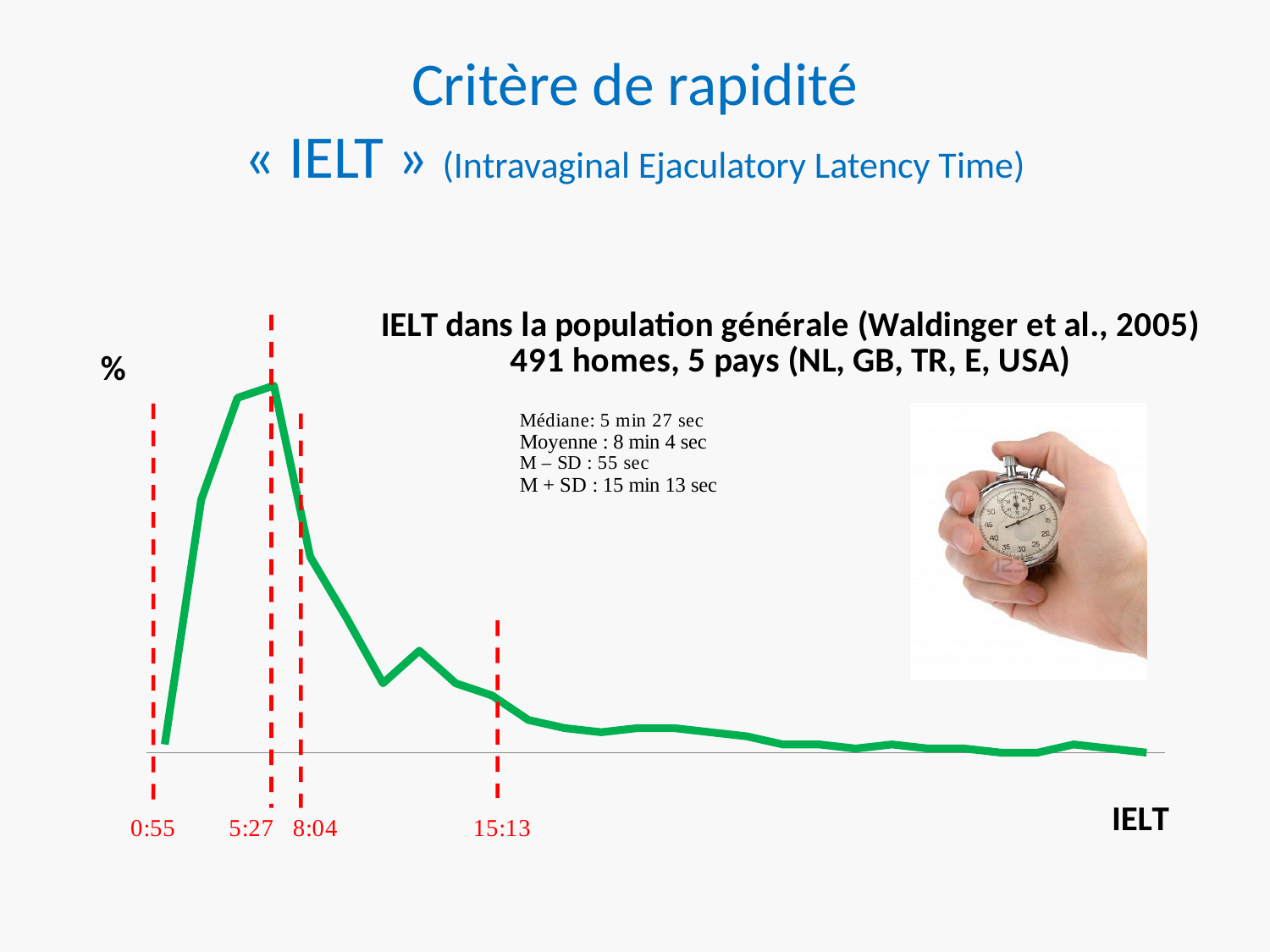
What label is shown on the x axis of the chart? IELT Is the value of the green line at the 8:04 marker higher or lower than at the 15:13 marker? higher Does the green line rise or fall between the 0:55 marker and the 5:27 marker? rise What is the mean (Moyenne) IELT value printed on the chart? 8 min 4 sec What kind of chart is shown on the slide? line chart What is the title of the chart? IELT dans la population générale (Waldinger et al., 2005) 491 homes, 5 pays (NL, GB, TR, E, USA) What is the median (Médiane) IELT value printed on the chart? 5 min 27 sec How many red dashed vertical markers are drawn on the chart? 4 Does the green line rise or fall along the x axis after the 5:27 marker? fall What value is given for M – SD on the chart? 55 sec At which red dashed marker on the x axis does the green line reach its peak? 5:27 What value is given for M + SD on the chart? 15 min 13 sec